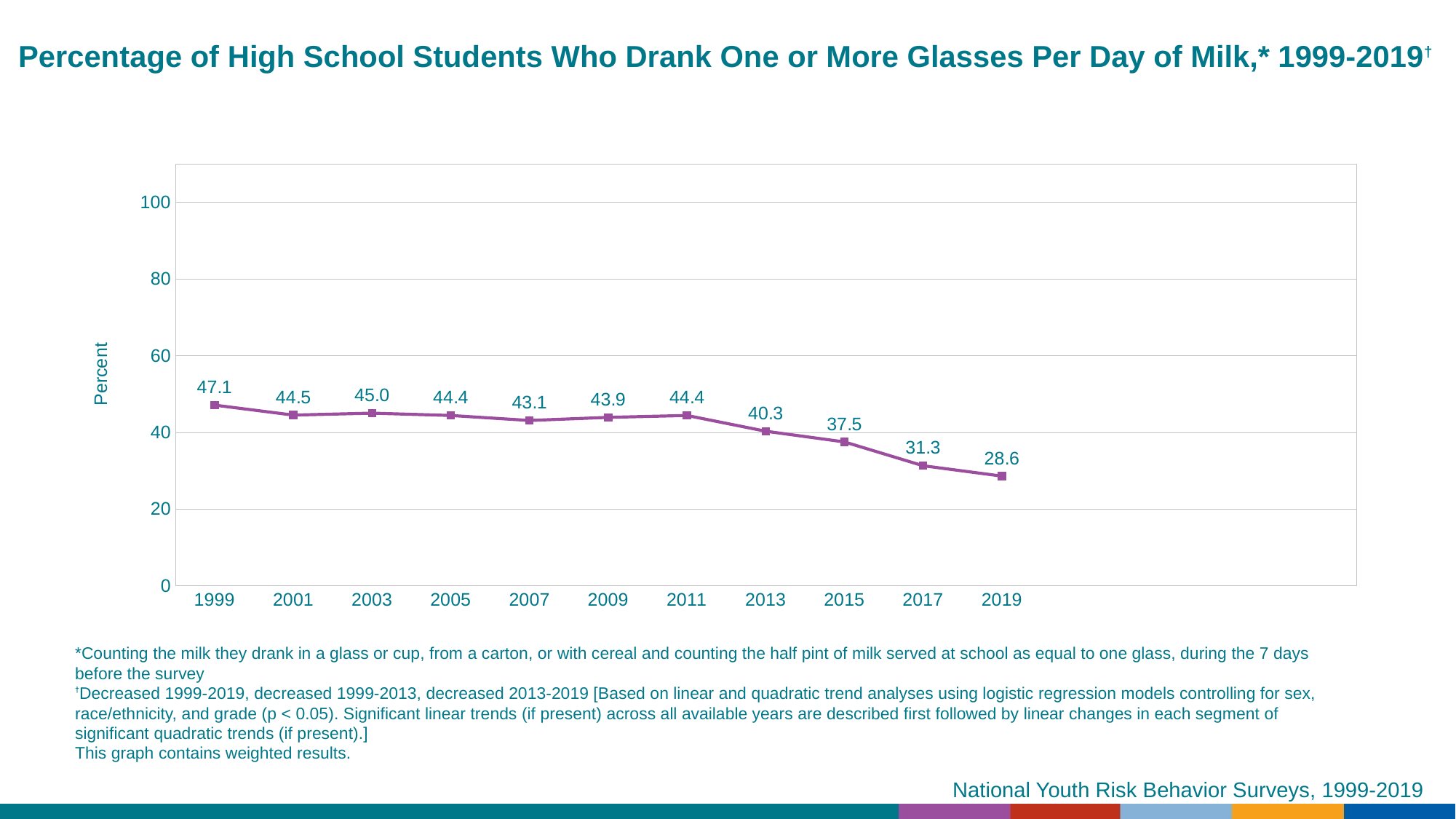
Which year has the highest value on the chart? 1999 What is the value plotted for 2019? 28.6 What percentage of high school students drank one or more glasses of milk per day in 1999? 47.1 Is the value for 2011 greater or less than 60? less Which is larger, the value for 2003 or the value for 2007? 2003 What is the difference between the values for 1999 and 2019? 18.5 What is the value plotted for 2013? 40.3 What kind of chart is shown on the slide? line chart What is the difference between the values for 2015 and 2017? 6.2 Do the values generally rise or fall from 1999 to 2019? fall Which year has the lowest value on the chart? 2019 How many years are plotted on the chart? 11